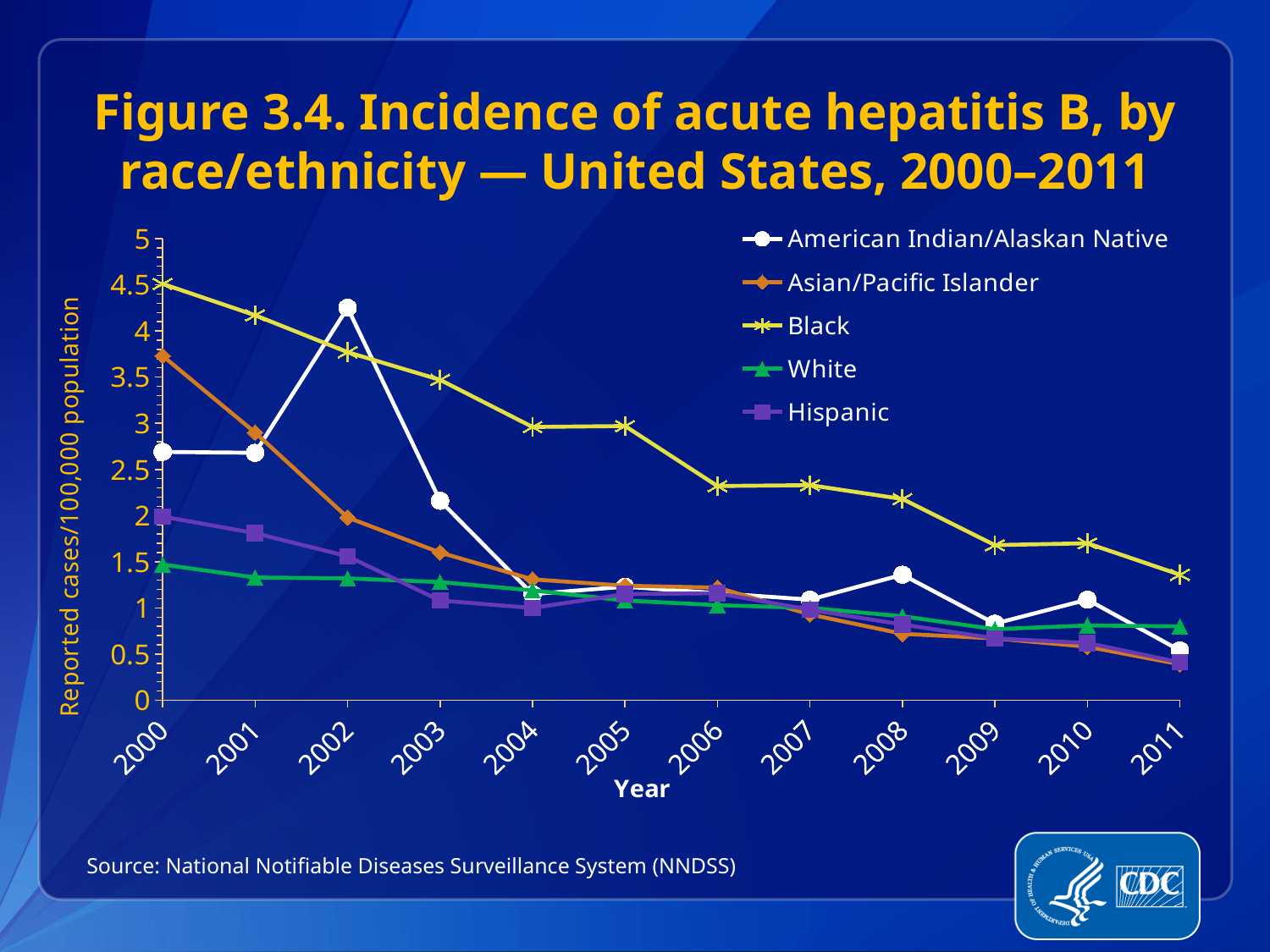
How many series does the legend list? 5 In 2002, which is higher: American Indian/Alaskan Native or Black? American Indian/Alaskan Native Which race/ethnicity group has the highest incidence in 2000? Black In which year does the American Indian/Alaskan Native series reach its highest value? 2002 What is the label on the y axis? Reported cases/100,000 population Is the value for American Indian/Alaskan Native in 2002 greater or less than 4? greater Is the value for Hispanic in 2000 greater or less than 1.5? greater Is the value for Black in 2000 greater or less than 4? greater Which race/ethnicity group has the lowest incidence in 2000? White What kind of chart is shown on the slide? line chart Does the Black series rise or fall from 2000 to 2011? fall How many years are plotted along the x axis? 12